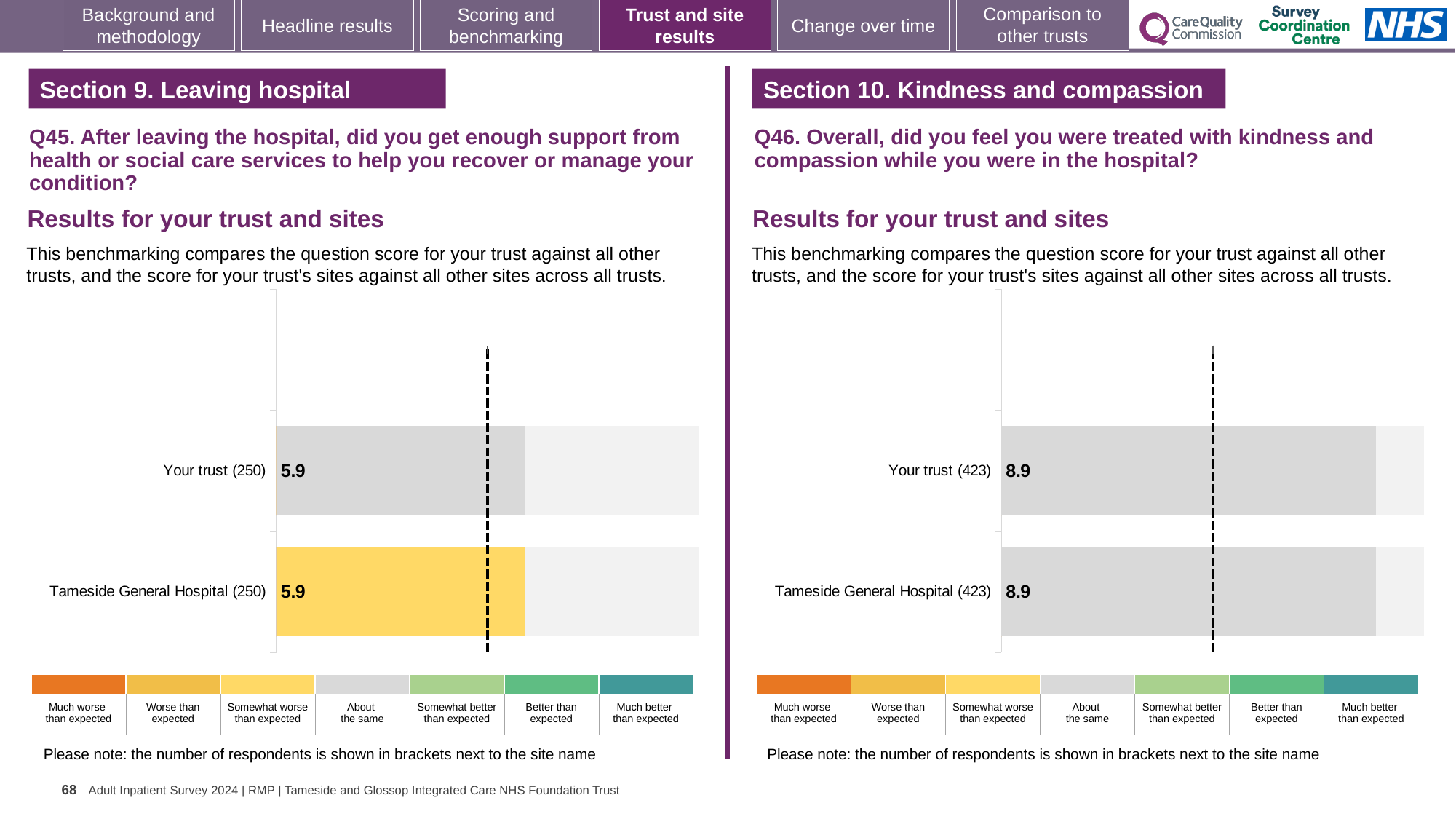
On the Q45 chart (left), what is the score for Tameside General Hospital? 5.9 On the Q45 chart (left), what is the score for Your trust? 5.9 On the Q45 chart (left), which benchmark category does the colour of the Tameside General Hospital bar correspond to in the key? Somewhat worse than expected On the Q45 chart (left), what is the difference between the score for Your trust and the score for Tameside General Hospital? 0 What kind of chart is used on the Q45 chart (left)? Bar chart How many bars are plotted on the Q46 chart (right)? 2 On the Q46 chart (right), what is the score for Your trust? 8.9 How many bars are plotted on the Q45 chart (left)? 2 On the Q46 chart (right), what is the score for Tameside General Hospital? 8.9 On the Q46 chart (right), how many respondents are shown in brackets for Your trust? 423 On the Q45 chart (left), how many respondents are shown in brackets for Tameside General Hospital? 250 On the Q46 chart (right), what is the difference between the score for Your trust and the score for Tameside General Hospital? 0